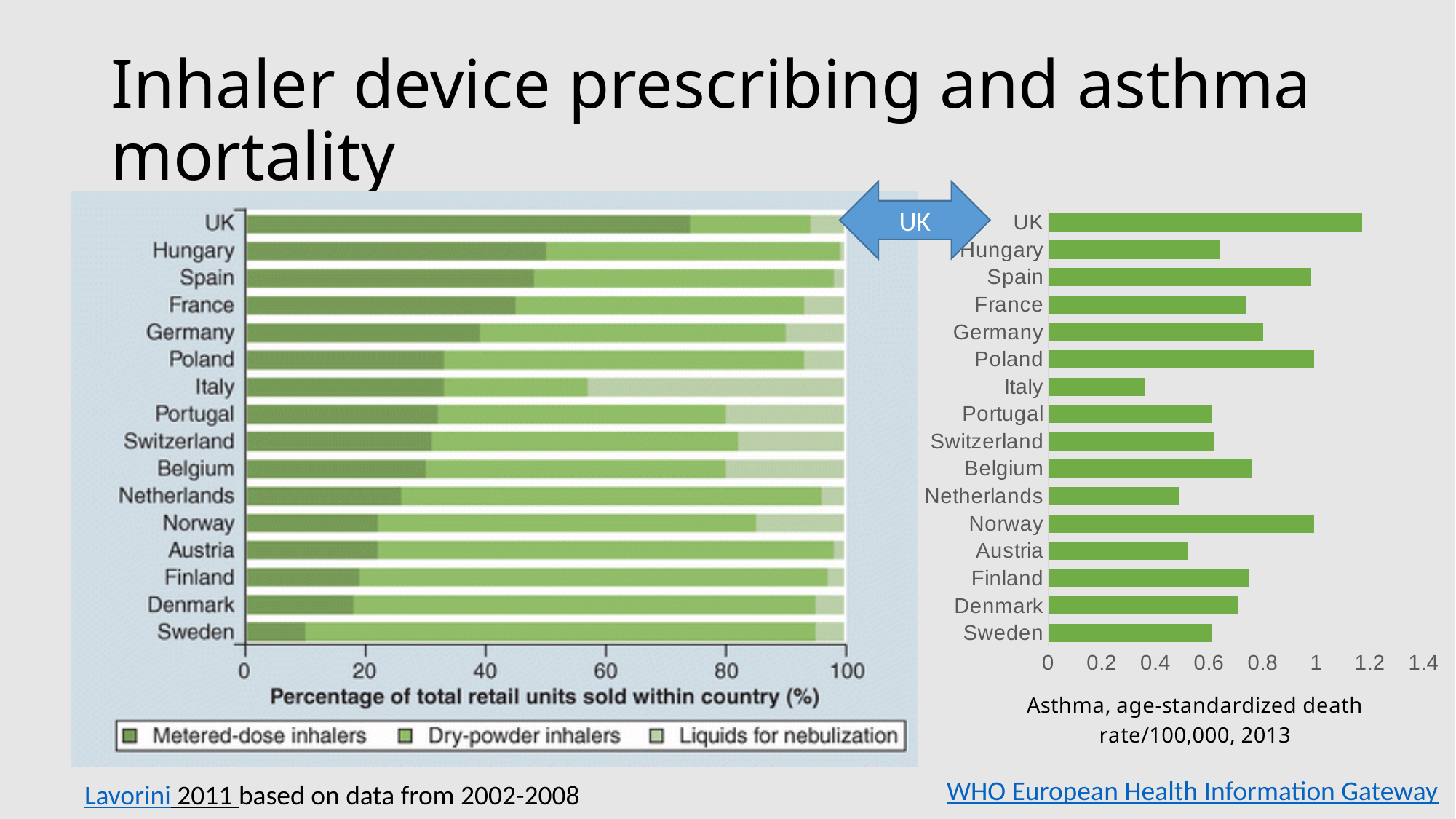
On the right chart (asthma death rate), which country has the lowest value? Italy What kind of chart is the left chart? Stacked bar chart On the left chart, how many series does the legend list? 3 On the left chart, which country has the lowest share of metered-dose inhalers? Sweden What is the x-axis label of the left chart? Percentage of total retail units sold within country (%) On the left chart, which country has the highest share of metered-dose inhalers? UK On the right chart (asthma death rate), which is larger, the value for Sweden or the value for Italy? Sweden On the right chart (asthma death rate), which country has the highest value? UK On the left chart, how many countries are shown? 16 On the left chart, is the metered-dose inhaler share for Sweden greater or less than 20? less On the right chart (asthma death rate), is the value for the UK greater or less than 1? greater On the left chart, is the metered-dose inhaler share for the UK greater or less than 60? greater